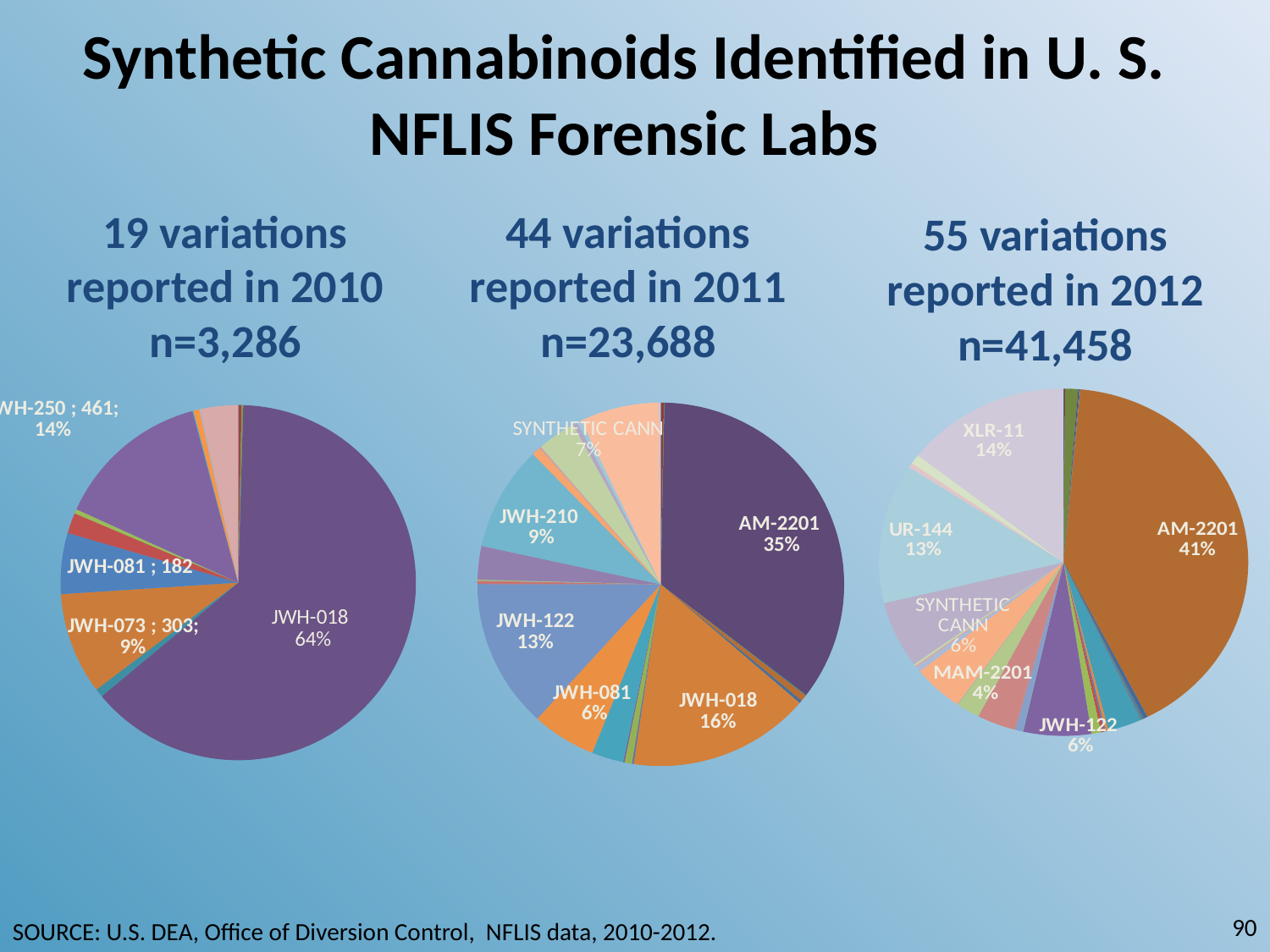
In the 2011 pie chart (middle), what share does AM-2201 have? 35% In the 2012 pie chart (right), what is the difference in percentage points between AM-2201 and UR-144? 28 percentage points In the 2012 pie chart (right), what share does XLR-11 have? 14% In the 2011 pie chart (middle), what share does JWH-018 have? 16% What kind of charts are shown on the slide? Pie charts In the 2011 pie chart (middle), what is the difference in percentage points between AM-2201 and JWH-018? 19 percentage points According to the heading above the middle pie chart, how many variations were reported in 2011? 44 variations In the 2011 pie chart (middle), which has the larger share, JWH-122 or JWH-210? JWH-122 In the 2012 pie chart (right), which labelled compound has the largest slice? AM-2201